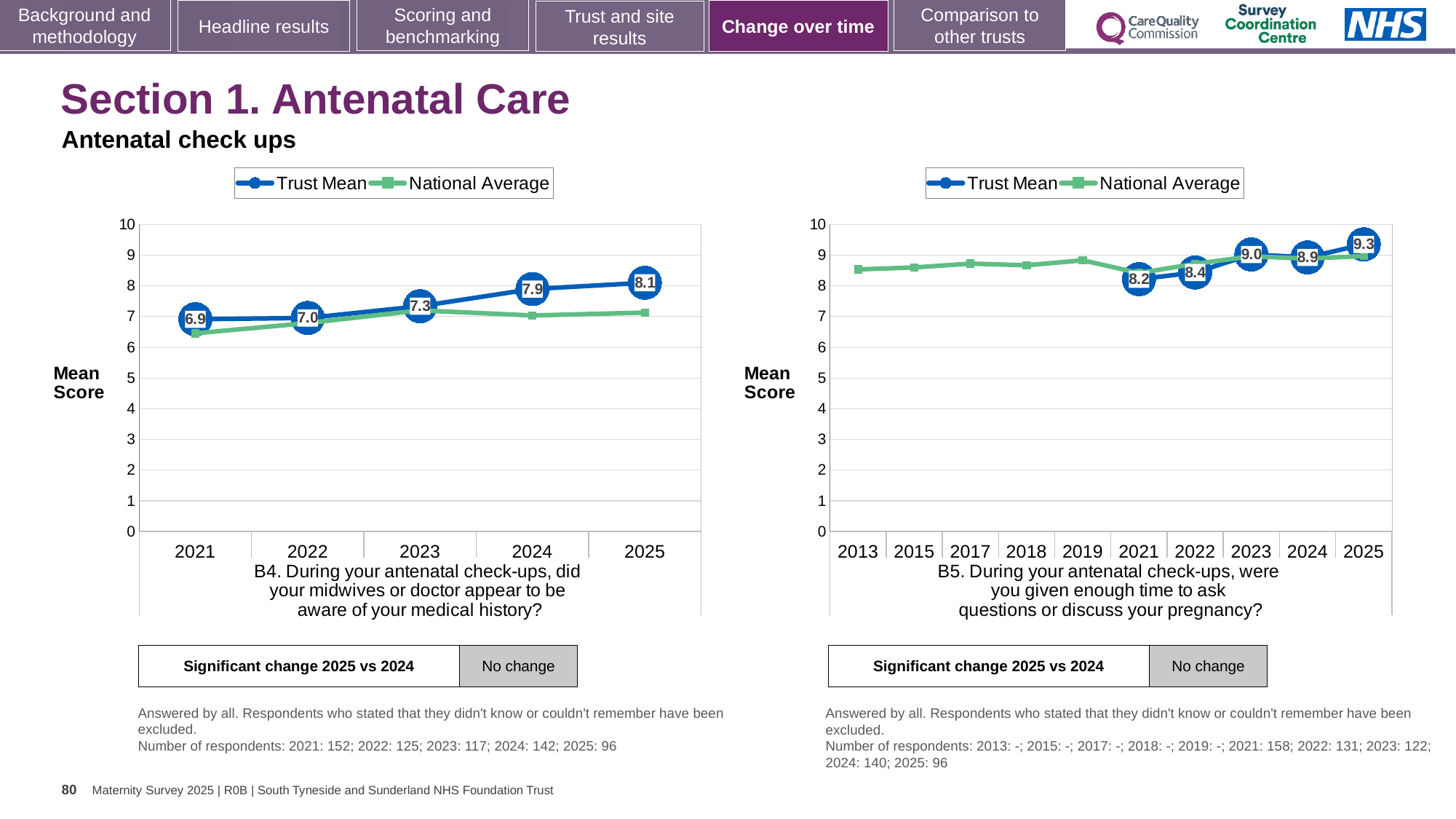
How many series does the legend of the left chart (B4) list? 2 In the right chart (B5), what is the Trust Mean score for 2025? 9.3 In the left chart (B4), which year has the highest Trust Mean score? 2025 In the left chart (B4), what is the Trust Mean score for 2021? 6.9 In the left chart (B4), what is the Trust Mean score for 2025? 8.1 In the right chart (B5), what is the Trust Mean score for 2023? 9.0 In the left chart (B4), is the National Average value for 2021 greater or less than 7? less How many years are shown on the x axis of the right chart (B5)? 10 What type of chart is the left chart (B4)? Line chart In the right chart (B5), which is larger, the Trust Mean for 2023 or for 2024? 2023 In the left chart (B4), what is the difference between the Trust Mean scores for 2025 and 2021? 1.2 In the right chart (B5), which year has the lowest Trust Mean score? 2021